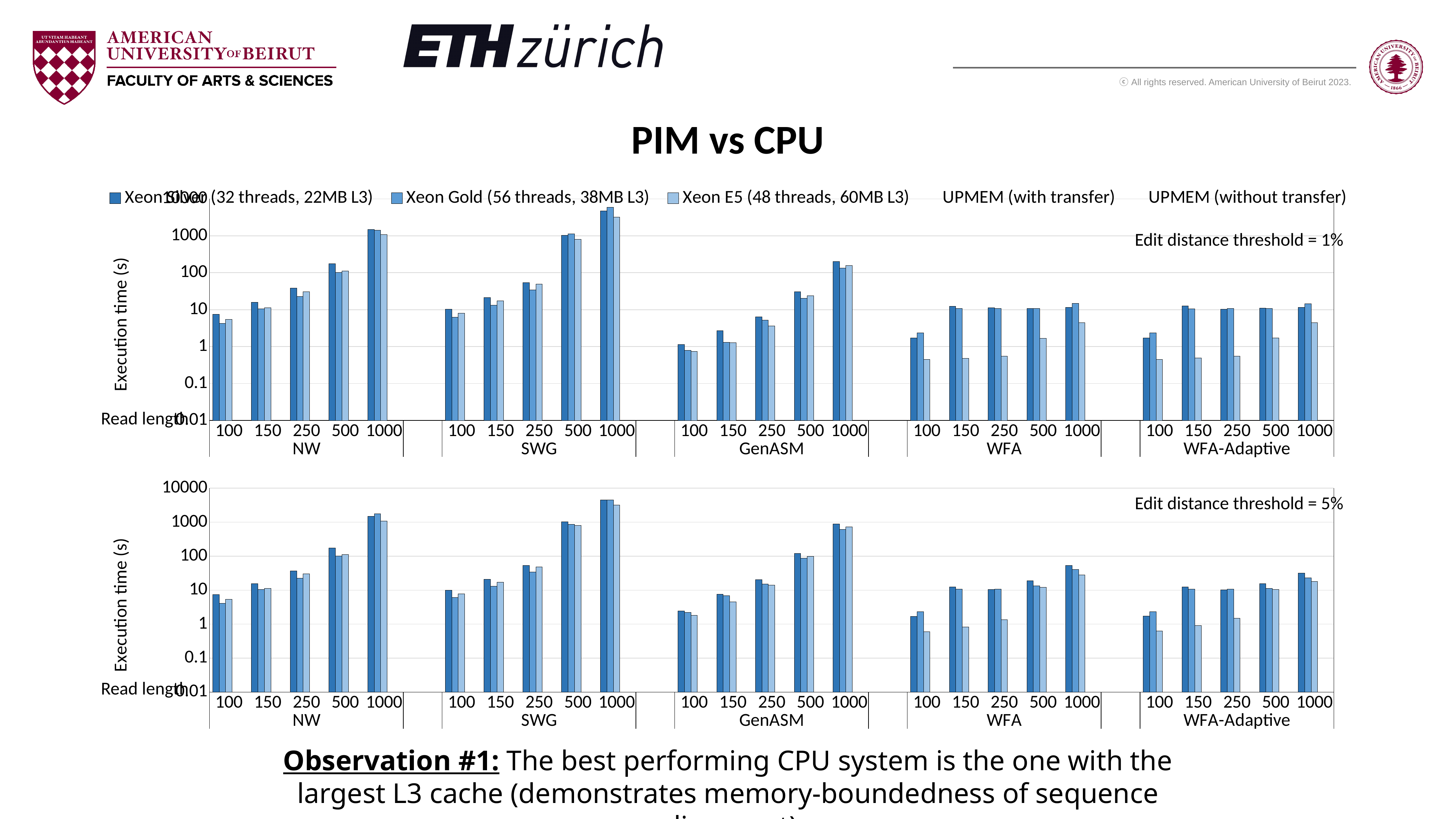
In the 'Edit distance threshold = 1%' chart, do the Xeon Silver values for NW rise or fall as read length increases from 100 to 1000? rise How many series does the legend list for the charts? 5 In the 'Edit distance threshold = 5%' chart, is the Xeon Silver value for GenASM at read length 1000 greater or less than 100? greater What kind of chart is used for the 'Edit distance threshold = 1%' chart? bar chart In the 'Edit distance threshold = 1%' chart, is the Xeon Silver value for NW at read length 1000 greater or less than 1000? greater In the 'Edit distance threshold = 1%' chart, is the Xeon E5 value for WFA at read length 100 greater or less than 1? less How many algorithm groups are shown along the x axis of the 'Edit distance threshold = 5%' chart? 5 In the 'Edit distance threshold = 1%' chart, which algorithm has the highest Xeon Gold execution time at read length 1000? SWG What is the y-axis label of the charts? Execution time (s) In the 'Edit distance threshold = 1%' chart, which is larger for Xeon Silver at read length 1000: NW or WFA? NW In the 'Edit distance threshold = 5%' chart, which is larger for Xeon Gold at read length 1000: SWG or NW? SWG